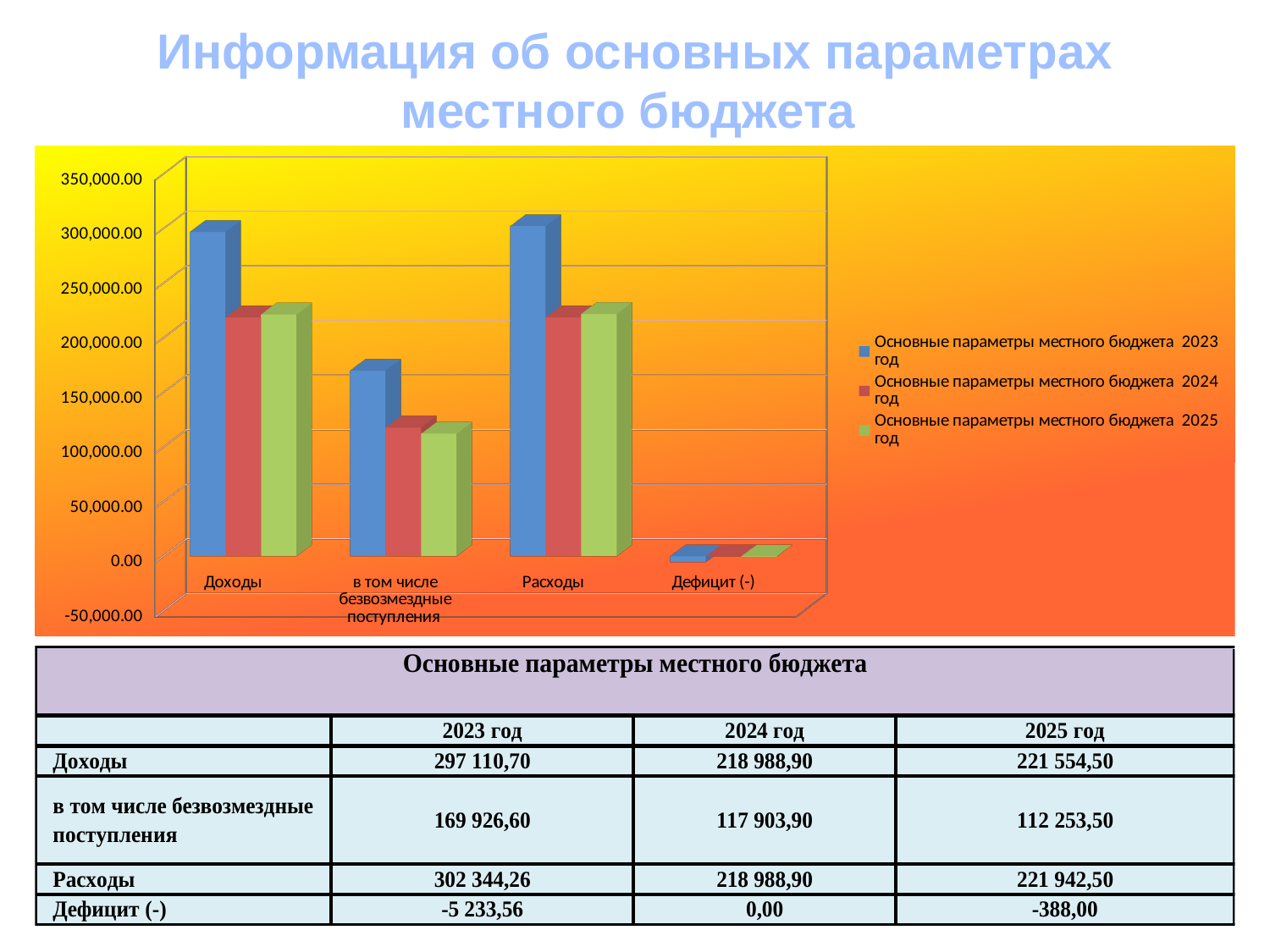
Is the value for Доходы in 2023 greater or less than 250,000.00? greater Using the table values, what is the difference between Доходы in 2023 год and Доходы in 2024 год? 78 121,80 According to the table on the slide, what is the value of Доходы for 2023 год? 297 110,70 Which category has the lowest values in the chart? Дефицит (-) Is the value for Расходы in 2024 greater or less than 250,000.00? less What kind of chart is shown on the slide? bar chart According to the table on the slide, what is the value of Дефицит (-) for 2025 год? -388,00 Which is larger, Доходы in 2023 or Доходы in 2024? Доходы in 2023 How many series does the chart legend list? 3 How many categories are shown on the x axis of the chart? 4 What is the title of the table below the chart? Основные параметры местного бюджета Is the value for в том числе безвозмездные поступления in 2025 greater or less than 150,000.00? less